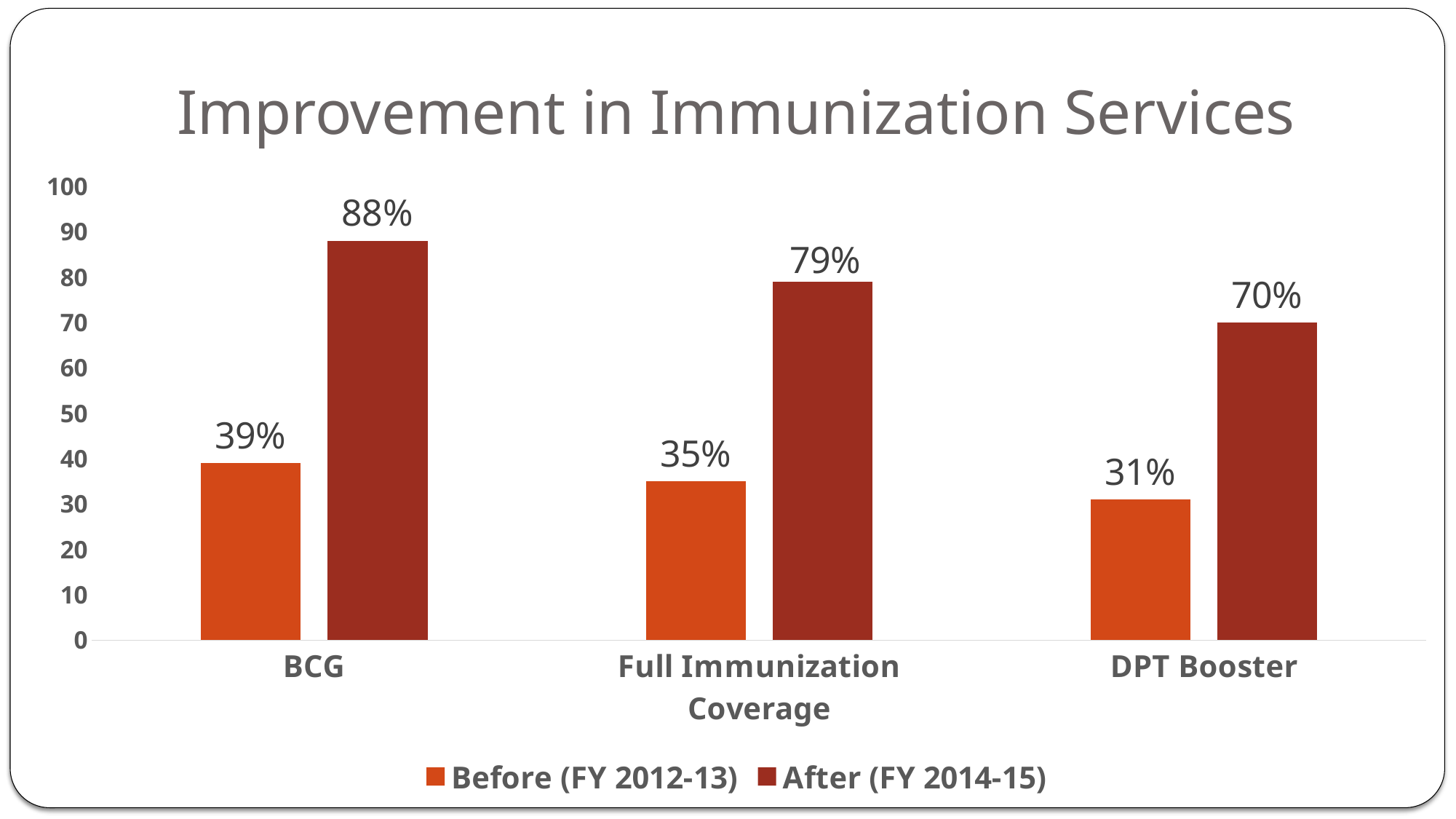
How many series does the legend list? 2 What is the difference between the After and Before values for BCG? 49% What is the After (FY 2014-15) value for DPT Booster? 70% What is the difference between the After and Before values for DPT Booster? 39% What is the After (FY 2014-15) value for Full Immunization Coverage? 79% Which category has the highest After (FY 2014-15) value? BCG What is the Before (FY 2012-13) value for BCG? 39% Which is larger: the Before value for BCG or the Before value for Full Immunization Coverage? BCG Which category has the lowest Before (FY 2012-13) value? DPT Booster How many categories are shown on the x axis? 3 What kind of chart is shown on the slide? Bar chart What is the title of the chart? Improvement in Immunization Services